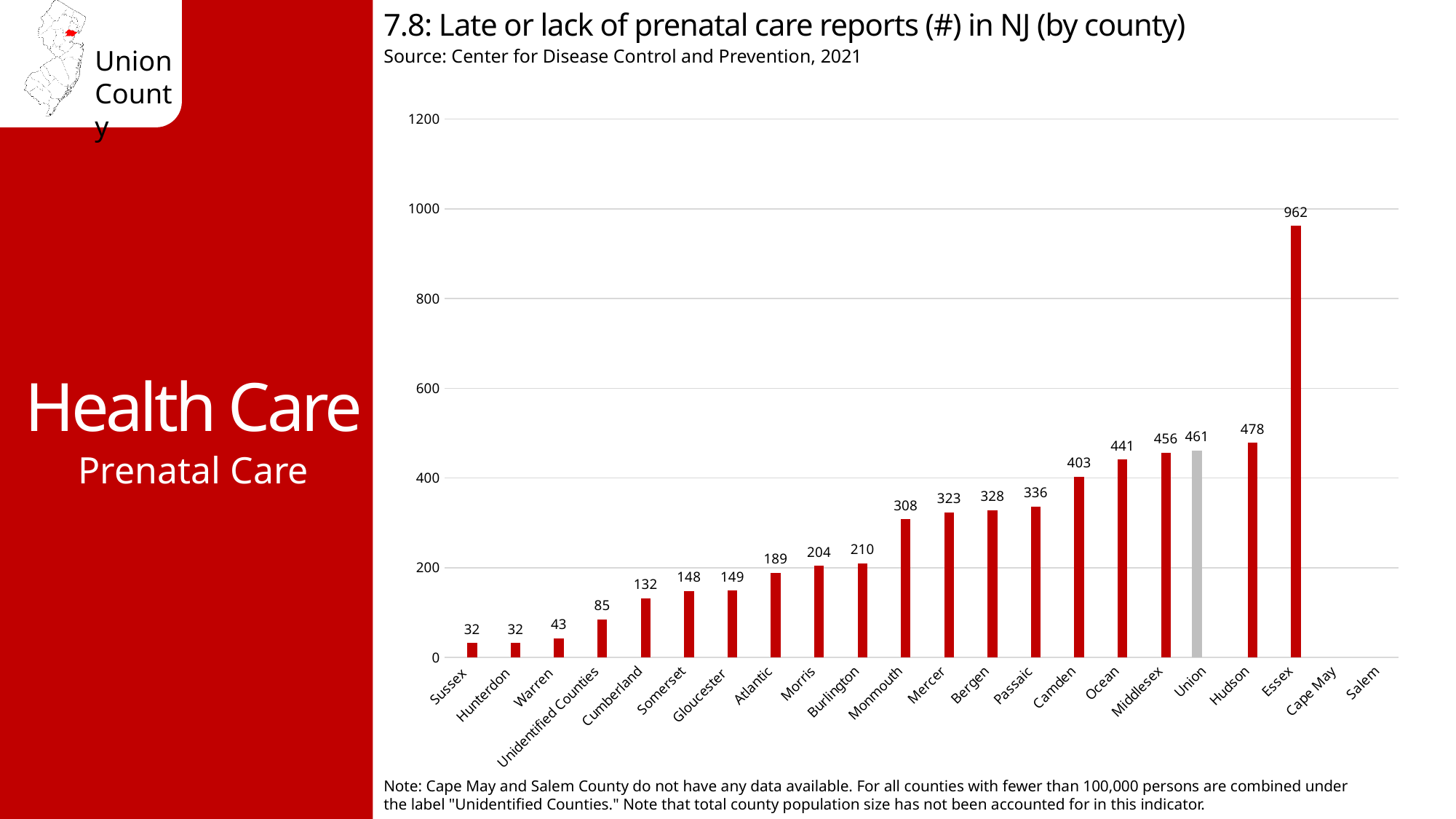
Which has a larger value, Camden or Ocean? Ocean Do the values generally rise or fall moving from Sussex to Essex along the x axis? Rise Which bar is coloured grey instead of red? Union What is the difference between the values for Essex and Hudson? 484 Which county has the highest number of late or lack of prenatal care reports? Essex What is the difference between the values for Union and Middlesex? 5 What is the value shown for Essex County? 962 What is the number of late or lack of prenatal care reports for Union County? 461 What kind of chart is shown on the slide? Bar chart What is the value shown for Unidentified Counties? 85 Is the value for Hudson greater or less than 400? greater Which has a larger value, Monmouth or Burlington? Monmouth